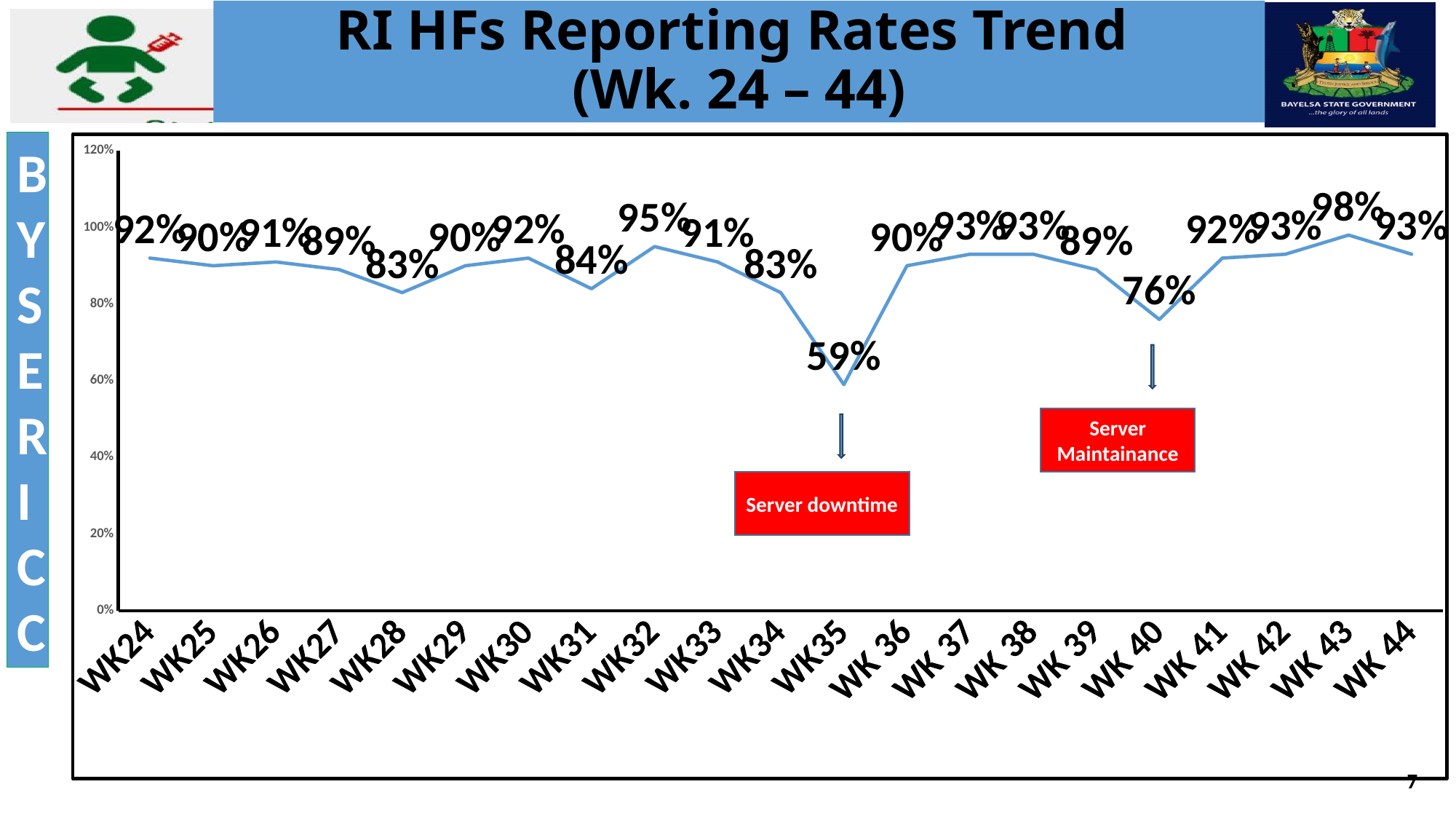
What is the reporting rate for WK32? 95% What label is attached to the dip at WK 40? Server Maintainance Which week has the lowest reporting rate? WK35 What is the reporting rate for WK24? 92% What is the difference between the reporting rates for WK 43 and WK35? 39% How many weeks are plotted on the chart? 21 Which week has the highest reporting rate? WK 43 What kind of chart is shown on the slide? Line chart Which has a higher reporting rate, WK28 or WK29? WK29 What is the reporting rate for WK 40? 76% What is the reporting rate for WK35? 59% What label is attached to the dip at WK35? Server downtime